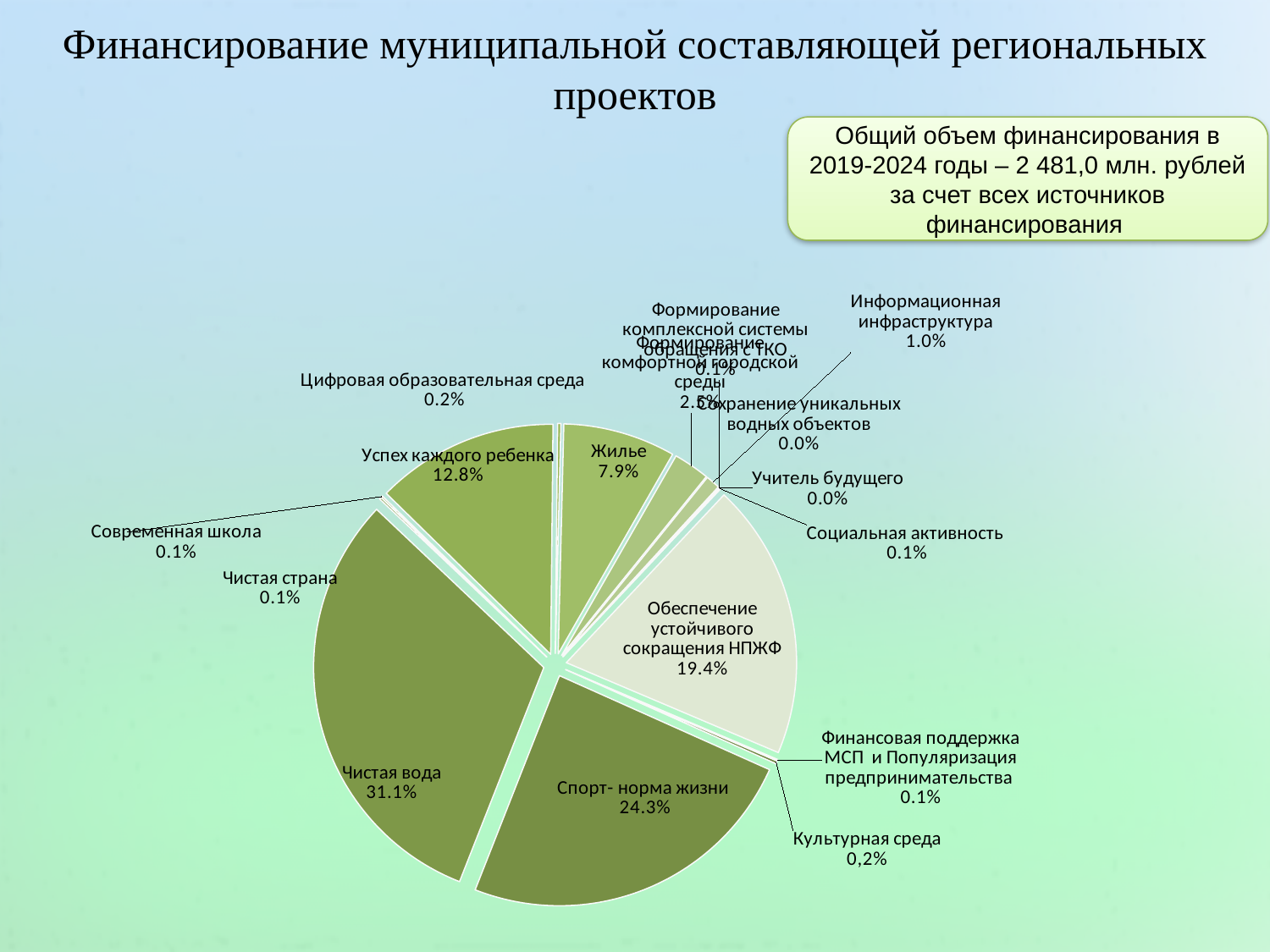
What is the difference in percentage points between "Успех каждого ребенка" and "Жилье"? 4.9 What share is labelled for "Информационная инфраструктура"? 1.0% Which category has the largest share of the pie? Чистая вода What share of financing does "Чистая вода" account for? 31.1% What share is shown for "Спорт- норма жизни"? 24.3% What share is shown for "Успех каждого ребенка"? 12.8% What percentage is labelled for "Обеспечение устойчивого сокращения НПЖФ"? 19.4% According to the text box on the slide, what is the total volume of financing for 2019-2024? 2 481,0 млн. рублей What kind of chart is shown on the slide? pie chart What is the difference in percentage points between "Чистая вода" and "Спорт- норма жизни"? 6.8 Which is larger, the share for "Спорт- норма жизни" or for "Обеспечение устойчивого сокращения НПЖФ"? Спорт- норма жизни What percentage is shown for "Жилье"? 7.9%